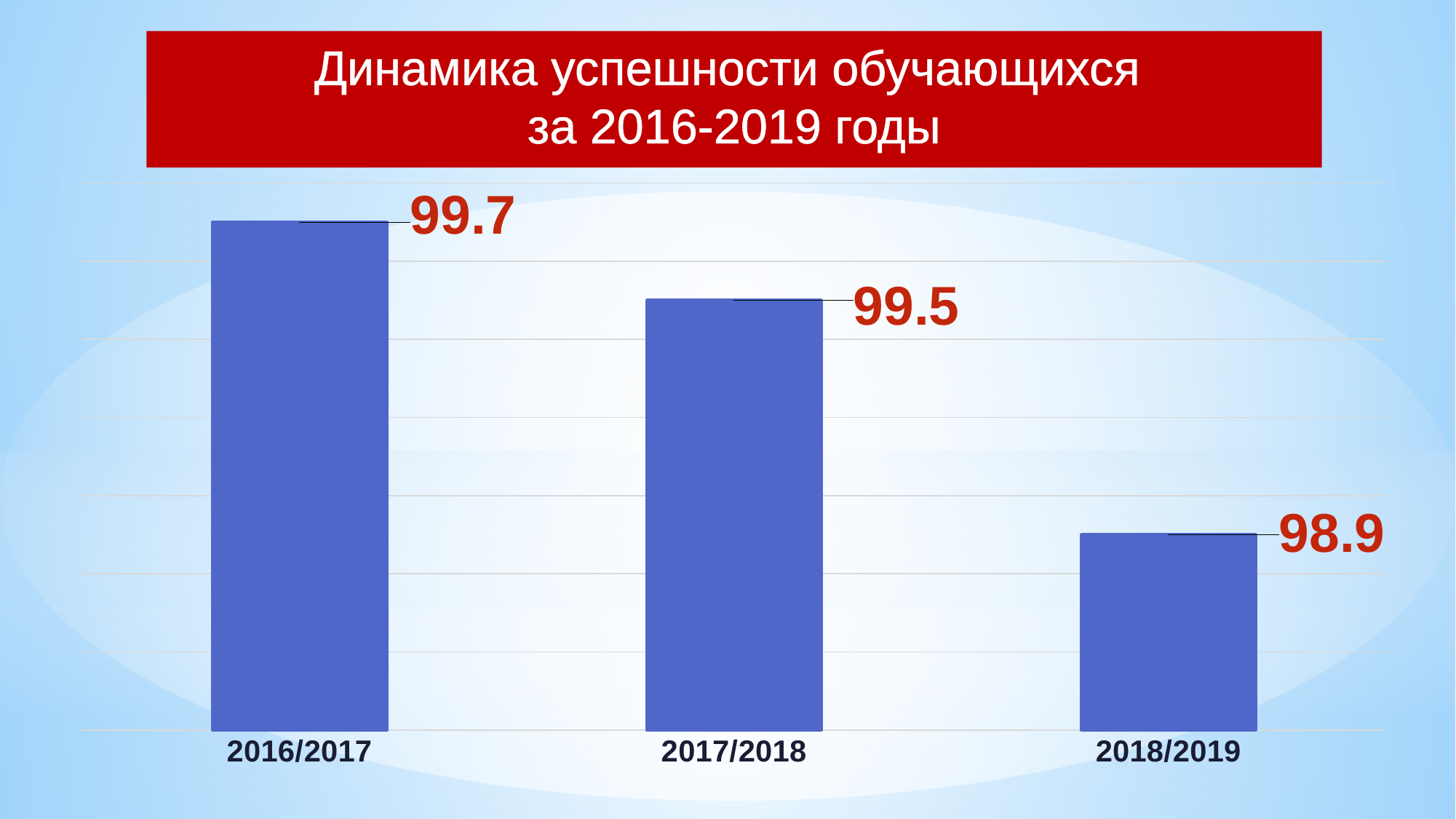
Which year has the highest value? 2016/2017 What kind of chart is shown on the slide? Bar chart What is the value for 2017/2018? 99.5 What is the title of the slide? Динамика успешности обучающихся за 2016-2019 годы What is the value for 2016/2017? 99.7 Which is larger, the value for 2017/2018 or the value for 2018/2019? 2017/2018 What is the difference between the values for 2016/2017 and 2018/2019? 0.8 Which year has the lowest value? 2018/2019 What is the difference between the values for 2016/2017 and 2017/2018? 0.2 What is the value for 2018/2019? 98.9 How many categories are shown on the chart? 3 Do the values rise or fall from 2016/2017 to 2018/2019? Fall